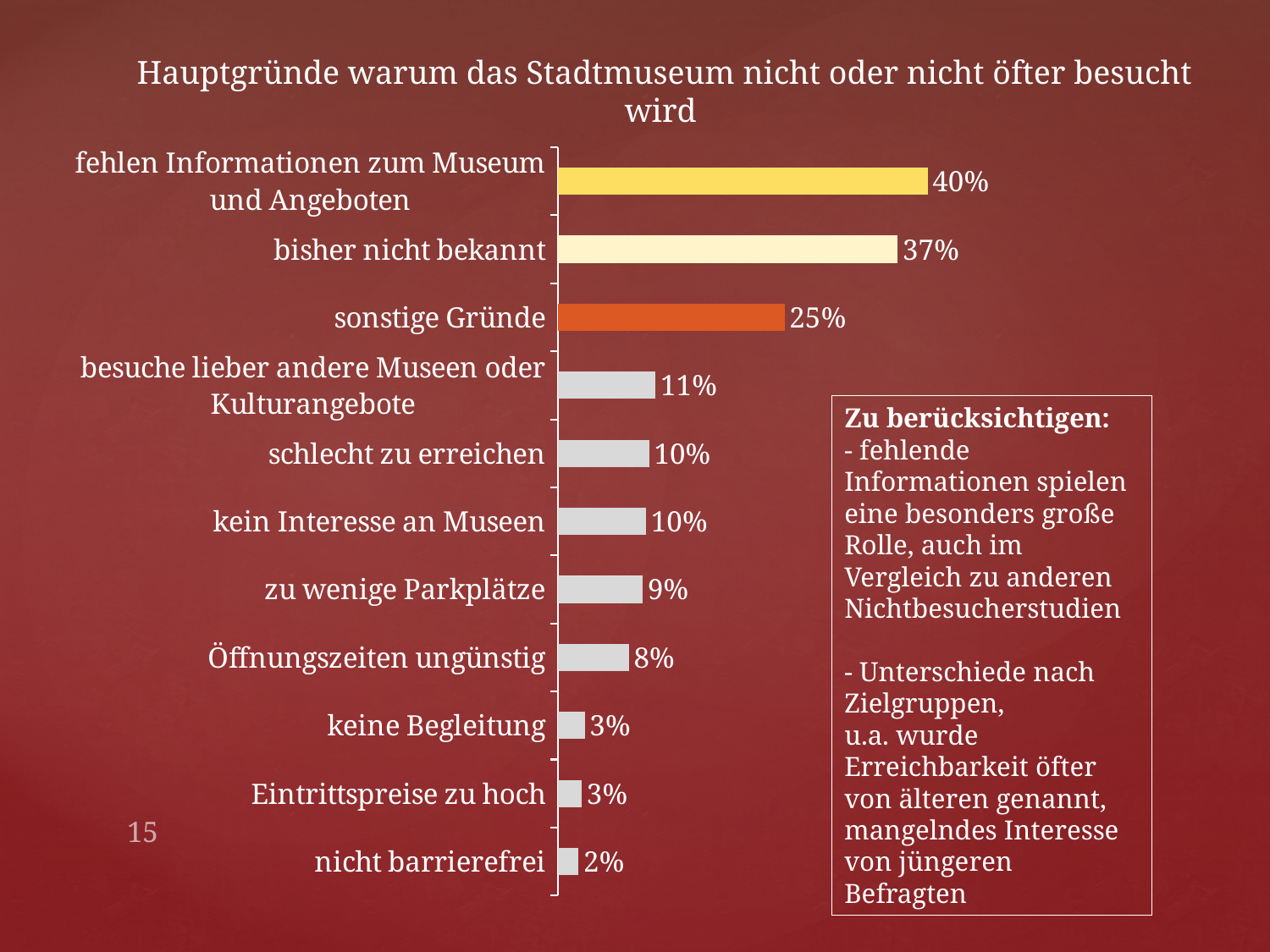
How many categories does the chart show? 11 What is the value for "Öffnungszeiten ungünstig"? 8% What is the title of the chart? Hauptgründe warum das Stadtmuseum nicht oder nicht öfter besucht wird Which category's bar is coloured orange? sonstige Gründe Which is larger, the value for "sonstige Gründe" or the value for "schlecht zu erreichen"? sonstige Gründe What kind of chart is shown on the slide? bar chart Which category has the lowest value? nicht barrierefrei What is the value for "zu wenige Parkplätze"? 9% What is the value for "bisher nicht bekannt"? 37% What is the difference between the values for "fehlen Informationen zum Museum und Angeboten" and "sonstige Gründe"? 15% Which category has the highest value? fehlen Informationen zum Museum und Angeboten What is the difference between the values for "besuche lieber andere Museen oder Kulturangebote" and "keine Begleitung"? 8%